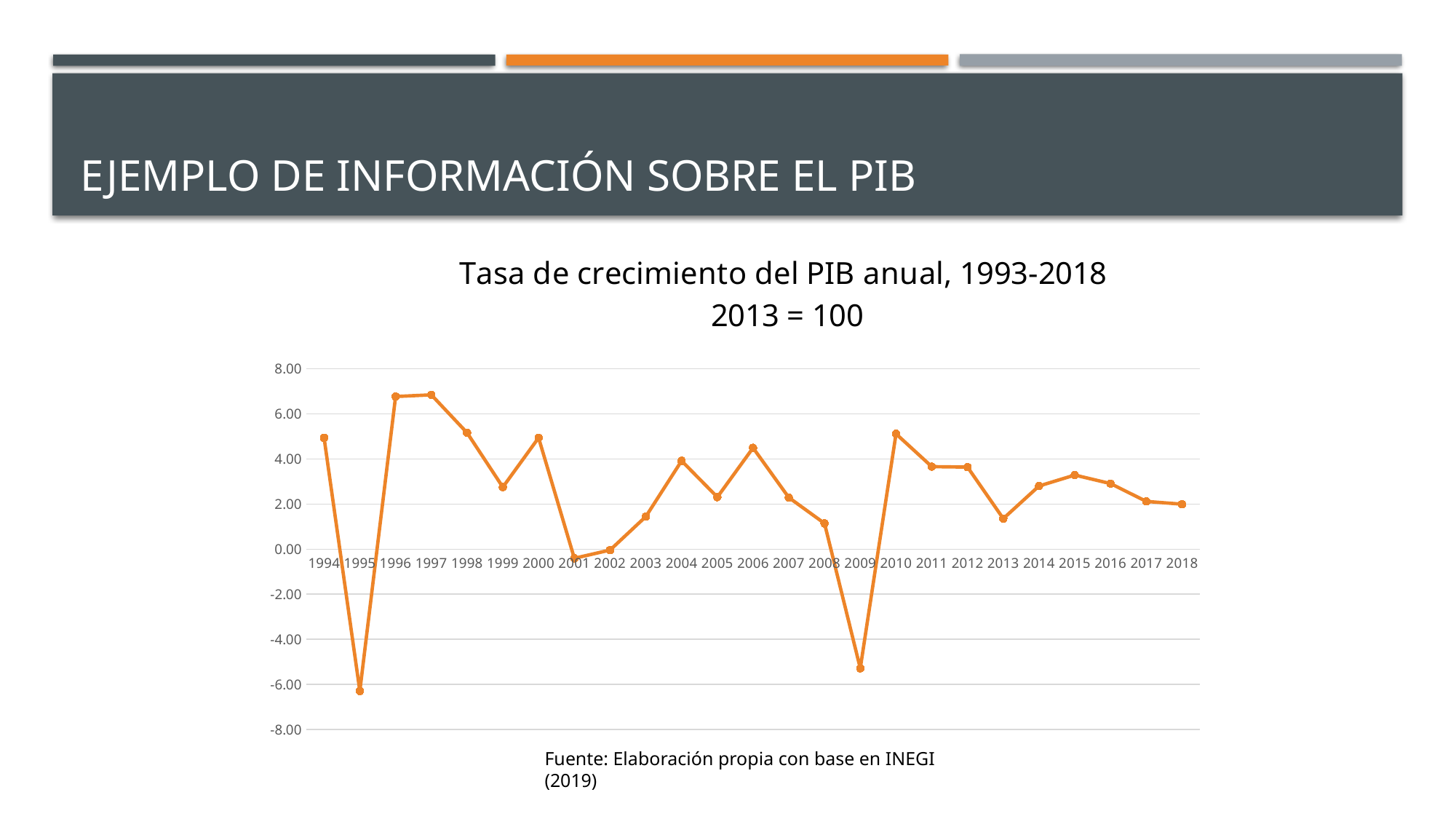
What kind of chart is shown on the slide? line chart Is the value for 2009 greater or less than -4.00? less Which year has the larger value, 2000 or 2001? 2000 What is the title of the chart? Tasa de crecimiento del PIB anual, 1993-2018 2013 = 100 Which year has the lowest value in the chart? 1995 Is the value for 1995 greater or less than -4.00? less Is the value for 1996 greater or less than 6.00? greater Do the values rise or fall from 2015 to 2018? fall Which year has the larger value, 1995 or 2009? 2009 How many years are plotted on the x axis of the chart? 25